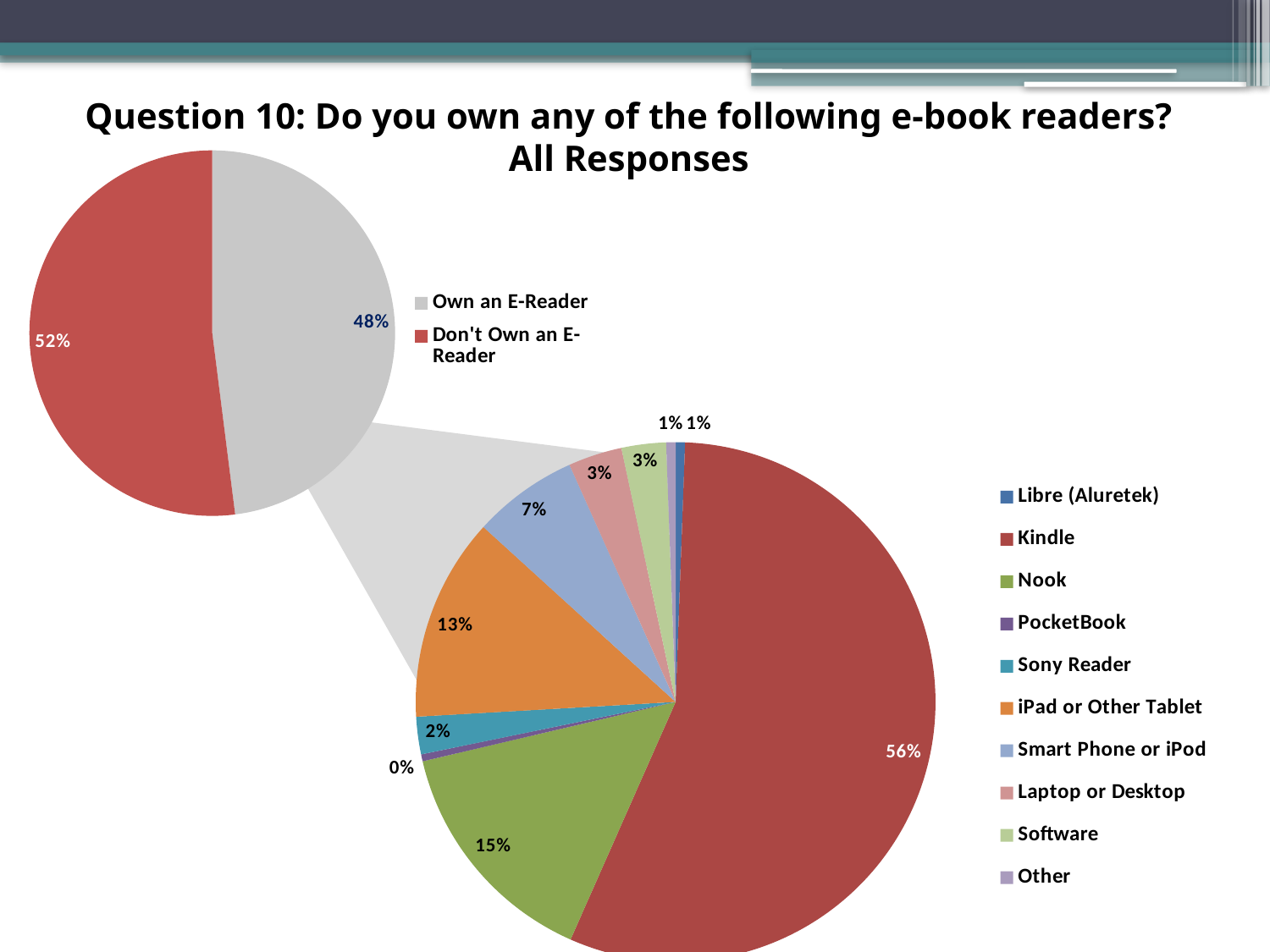
In the smaller pie chart on the left, what percentage of respondents own an e-reader? 48% In the larger pie chart on the right, what share is labelled for iPad or Other Tablet? 13% In the larger pie chart on the right, what share is labelled for Kindle? 56% In the larger pie chart on the right, what share is labelled for Smart Phone or iPod? 7% In the larger pie chart on the right, what is the difference between the Kindle share and the Nook share? 41% How many categories does the legend of the larger pie chart on the right list? 10 In the smaller pie chart on the left, which slice is larger: Own an E-Reader or Don't Own an E-Reader? Don't Own an E-Reader In the smaller pie chart on the left, what percentage of respondents don't own an e-reader? 52% In the larger pie chart on the right, which is larger: the share for Nook or the share for iPad or Other Tablet? Nook In the larger pie chart on the right, which category has the largest share? Kindle What type of chart is used on this slide? Pie chart In the larger pie chart on the right, what share is labelled for Nook? 15%